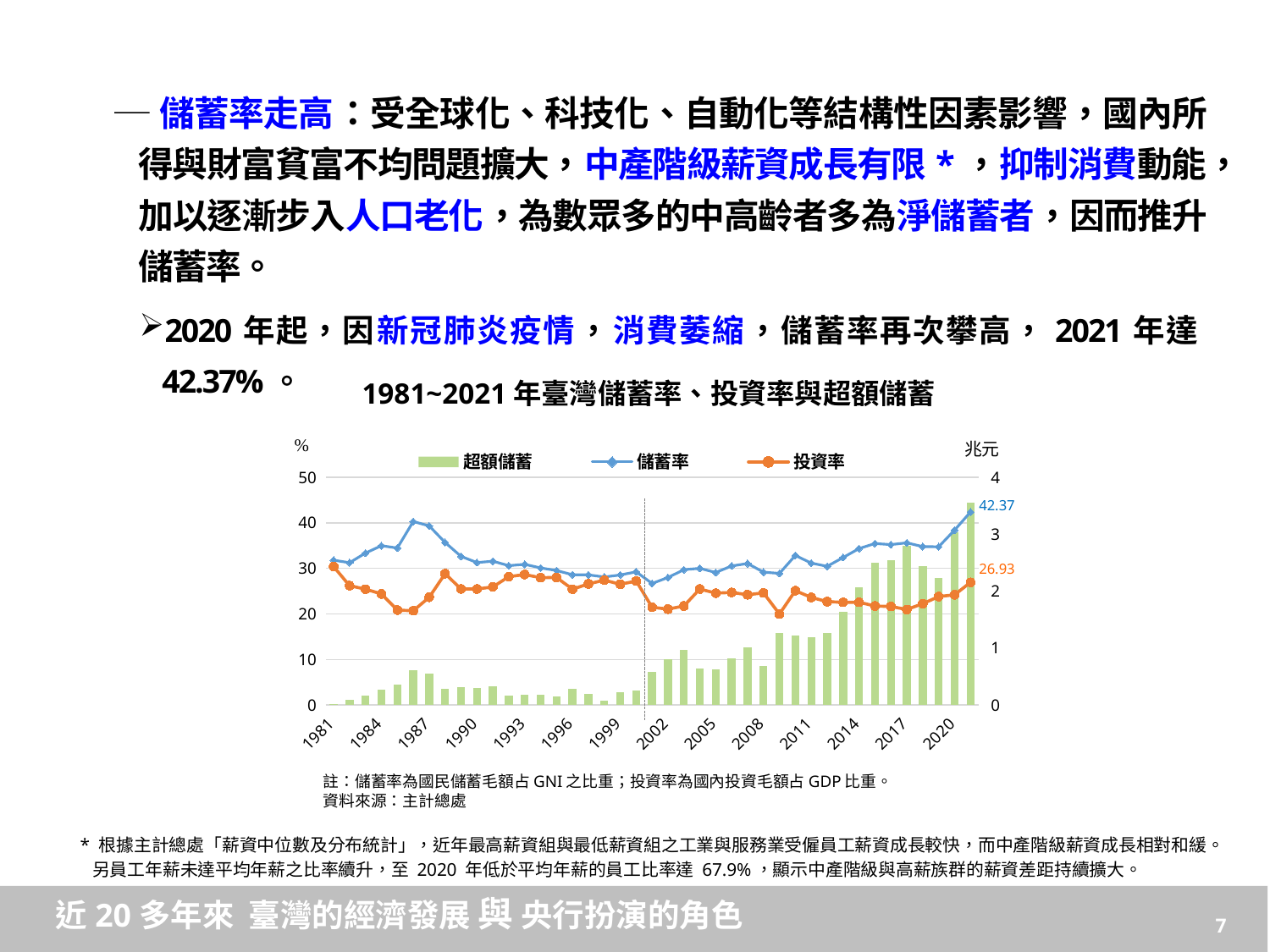
Is the 儲蓄率 value for 1987 greater or less than 30? greater Is the 超額儲蓄 bar for 2021 greater or less than 3 兆元? greater What is the title of the chart? 1981~2021 年臺灣儲蓄率、投資率與超額儲蓄 What is the 儲蓄率 value labelled for 2021 on the chart? 42.37 Does the 儲蓄率 line rise or fall from 2019 to 2021? rise How many series does the chart legend list? 3 What unit is shown on the right-hand axis of the chart? 兆元 What is the 投資率 value labelled for 2021 on the chart? 26.93 What is the difference between the 2021 儲蓄率 (42.37) and the 2021 投資率 (26.93)? 15.44 What kind of chart is shown on the slide? Combined bar and line chart In 2021, which is larger, 儲蓄率 or 投資率? 儲蓄率 Is the 投資率 value for 1986 greater or less than 25? less